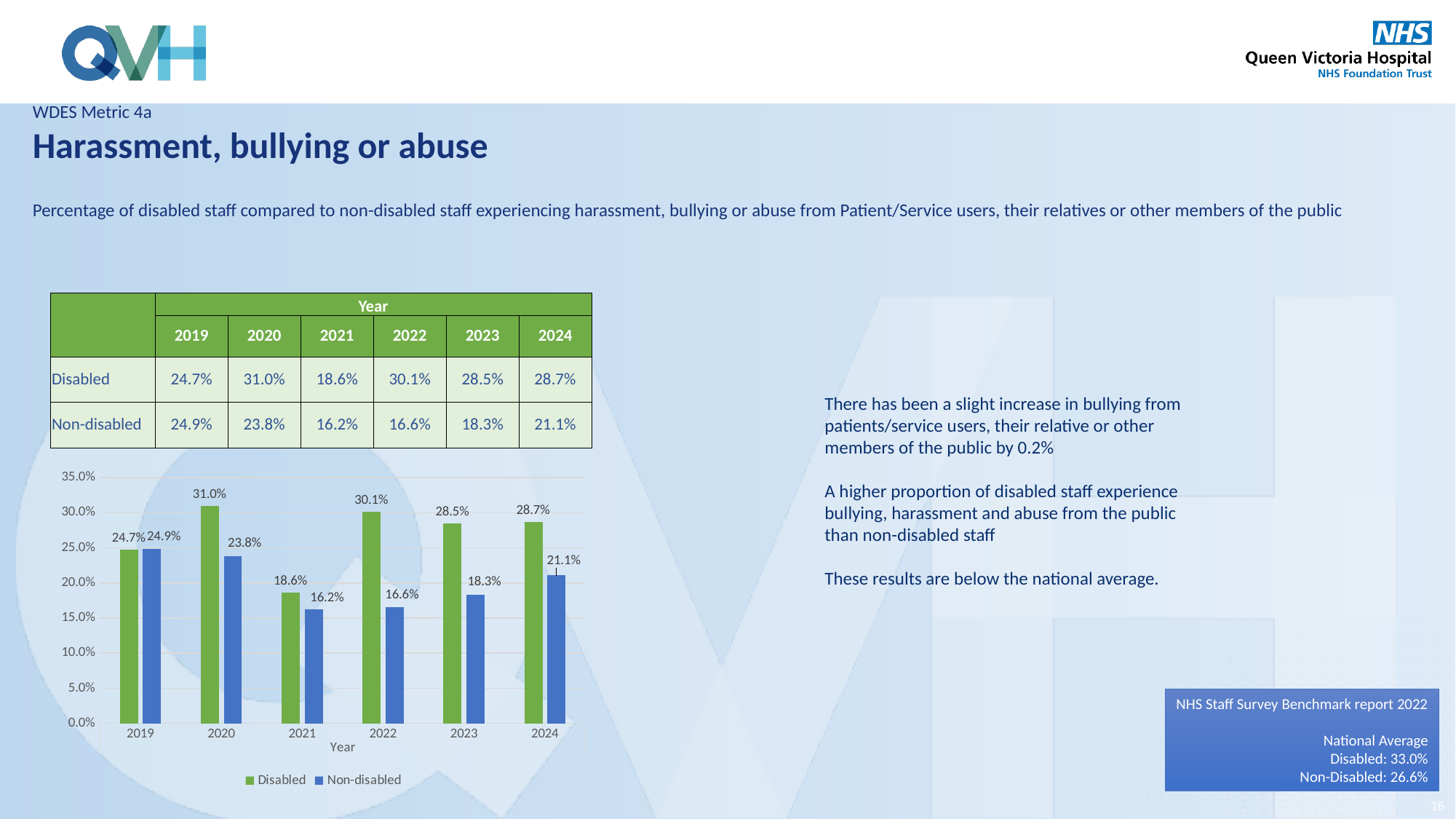
How many series does the chart legend list? 2 What is the difference between the Disabled and Non-disabled values in 2022? 13.5% What is the value for Non-disabled staff in 2021? 16.2% Which year has the highest value for Disabled staff? 2020 What is the value for Disabled staff in 2020? 31.0% Is the value for Disabled staff in 2021 greater or less than 20.0%? less How many years are shown on the x axis of the chart? 6 What kind of chart is shown on the slide? Bar chart What is the value for Non-disabled staff in 2024? 21.1% Which year has the lowest value for Non-disabled staff? 2021 Which colour represents the Disabled series in the chart? Green Which is larger in 2019, the Disabled value or the Non-disabled value? Non-disabled